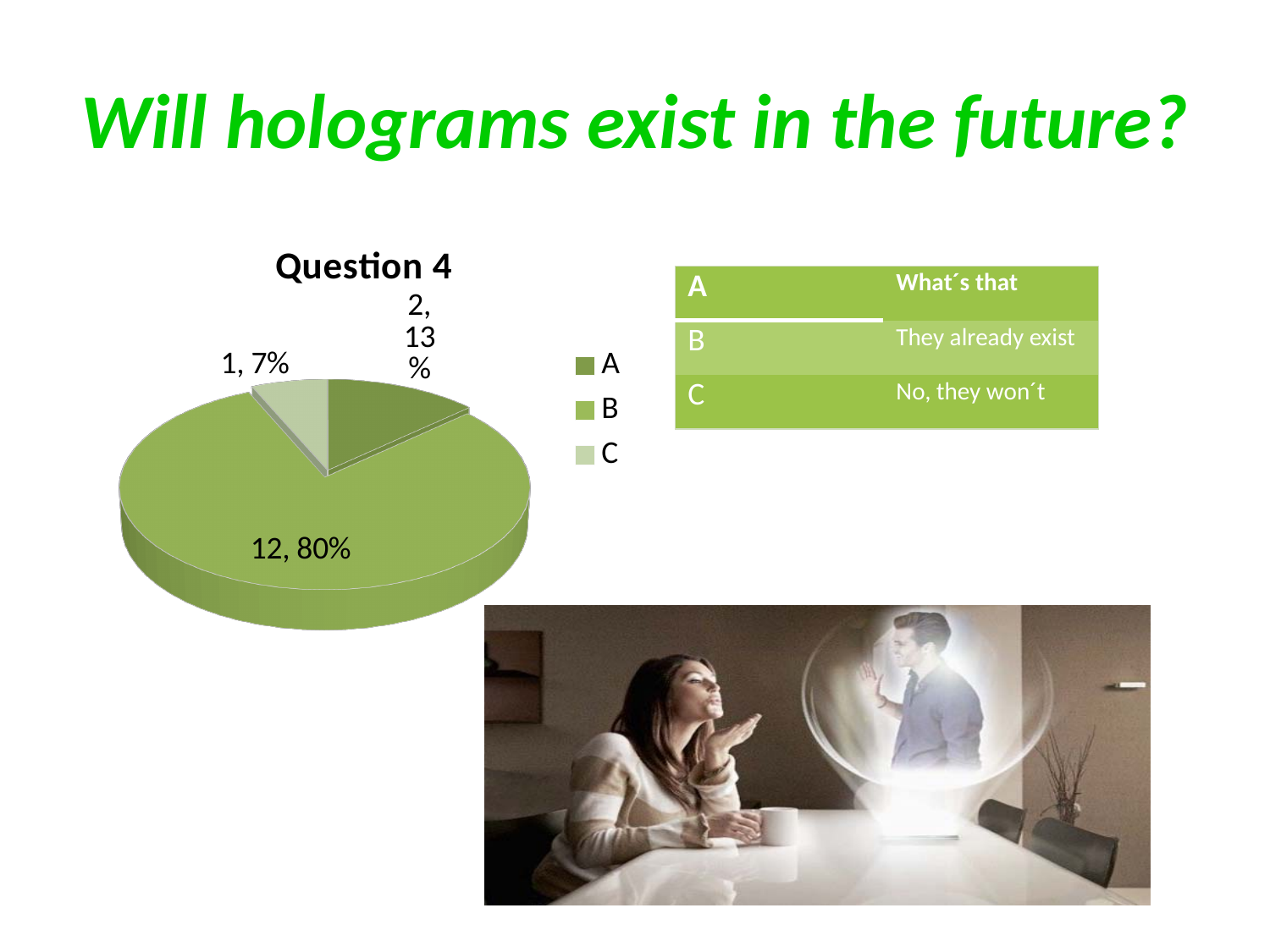
How many slices does the pie chart have? 3 What count is shown for slice C in the pie chart? 1 What count is shown for slice A in the pie chart? 2 What share of the pie does slice A represent? 13% What type of chart is shown on the slide? pie chart Which slice is the largest in the pie chart? B Which slice is the smallest in the pie chart? C What is the title of the pie chart? Question 4 What share of the pie does slice B represent? 80% What is the difference in count between slice B and slice A in the pie chart? 10 What count is shown for slice B in the pie chart? 12 How many entries does the legend of the pie chart list? 3